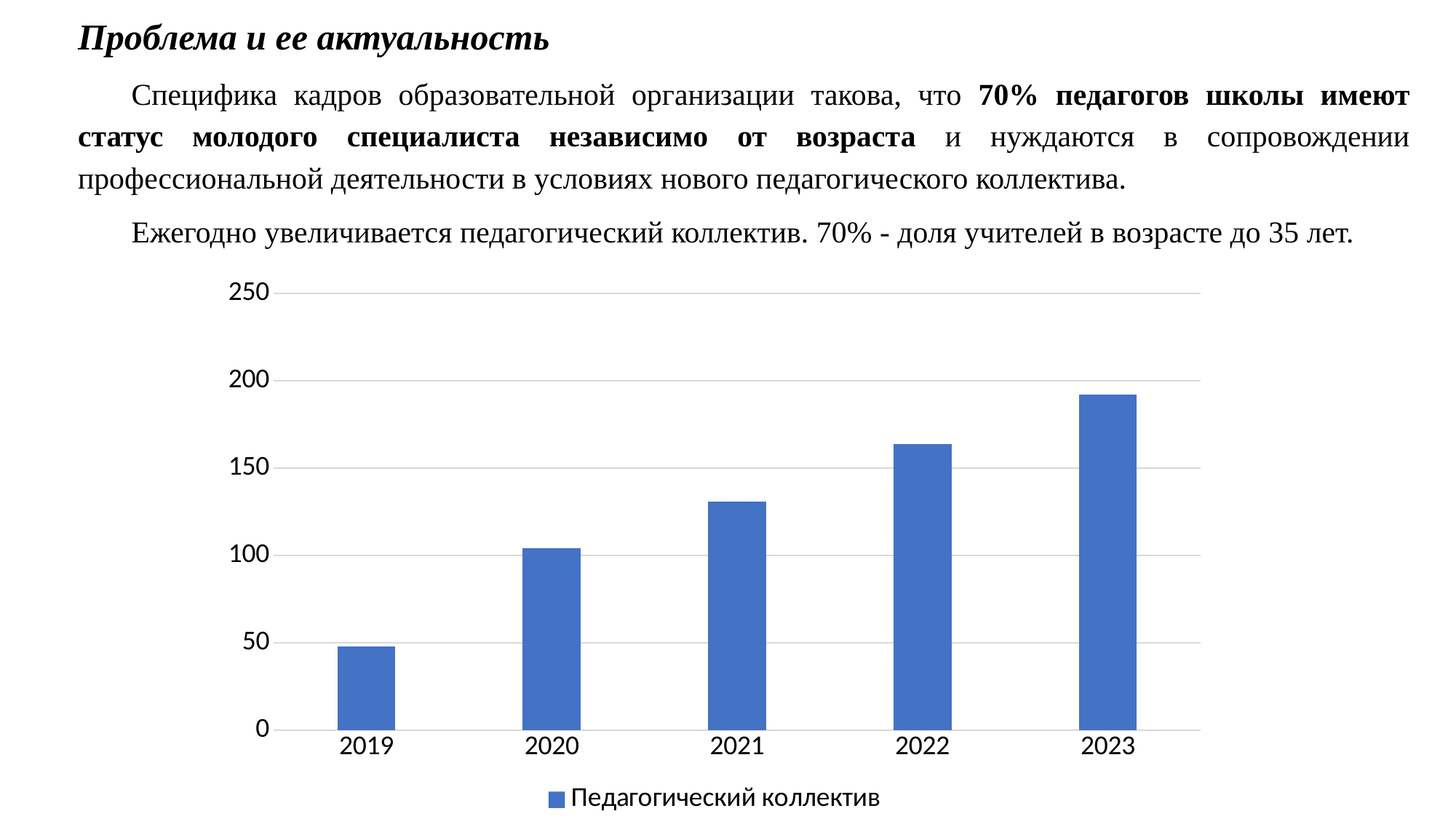
Do the values in the chart rise or fall from 2019 to 2023? rise Is the value for 2022 greater or less than 150? greater Which year has the highest value in the chart? 2023 Is the value for 2021 greater or less than 150? less How many series does the chart legend list? 1 How many years are shown on the x axis of the chart? 5 Is the value for 2023 greater or less than 200? less Which year has the lowest value in the chart? 2019 Which is larger, the value for 2020 or the value for 2022? 2022 What is the name of the series shown in the chart legend? Педагогический коллектив What kind of chart is shown on the slide? bar chart